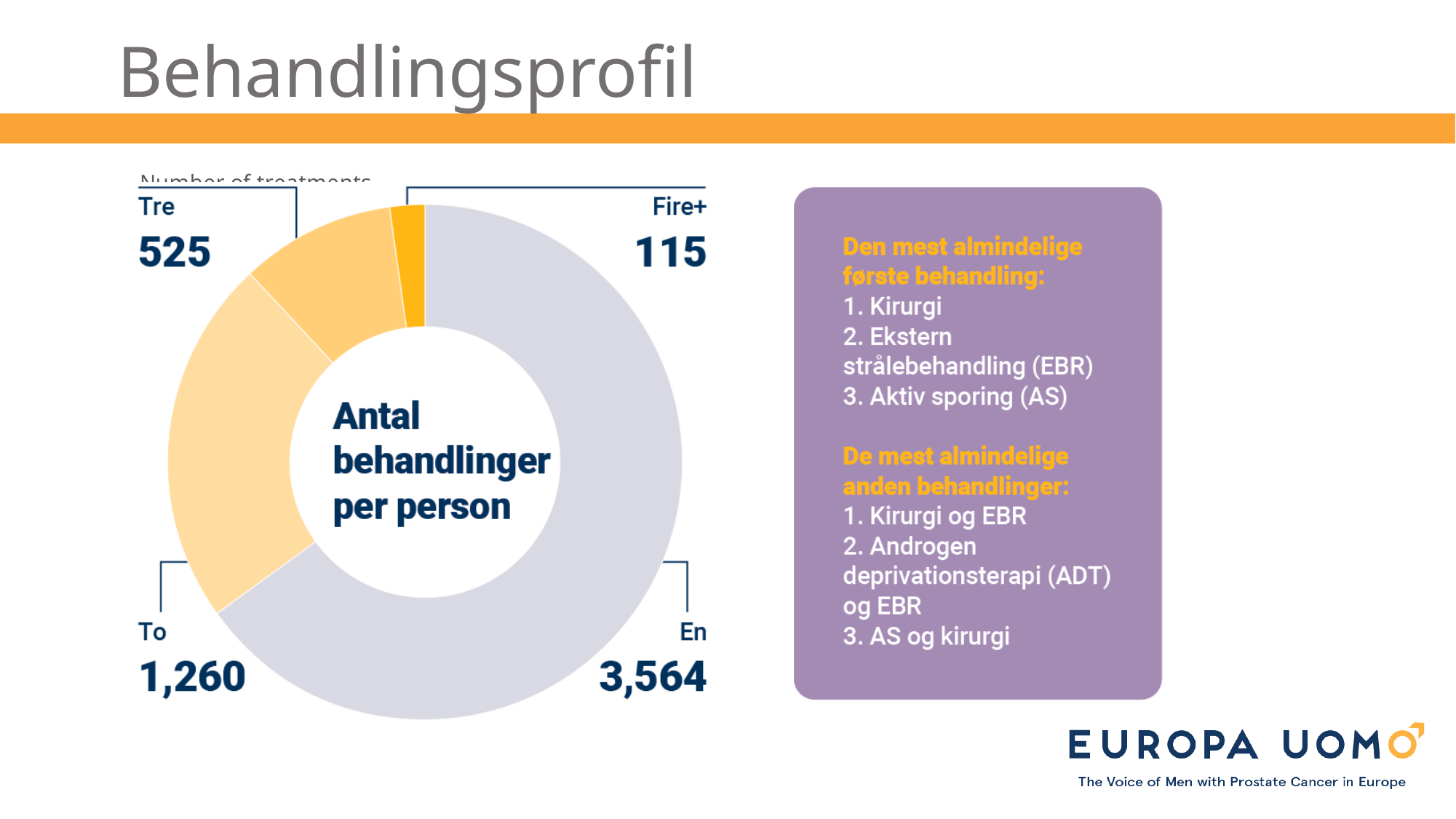
What is the value for the 'En' segment of the donut chart? 3,564 Which category has the largest segment in the donut chart? En What is the difference between the 'En' and 'To' values in the donut chart? 2,304 What kind of chart is shown on the slide? Donut chart What text is written in the centre of the donut chart? Antal behandlinger per person Which is larger in the donut chart, the value for 'To' or the value for 'Tre'? To How many categories are shown in the donut chart? 4 What is the value for the 'Fire+' segment of the donut chart? 115 What is the difference between the 'Tre' and 'Fire+' values in the donut chart? 410 Which category has the smallest segment in the donut chart? Fire+ What is the value for the 'To' segment of the donut chart? 1,260 What is the value for the 'Tre' segment of the donut chart? 525